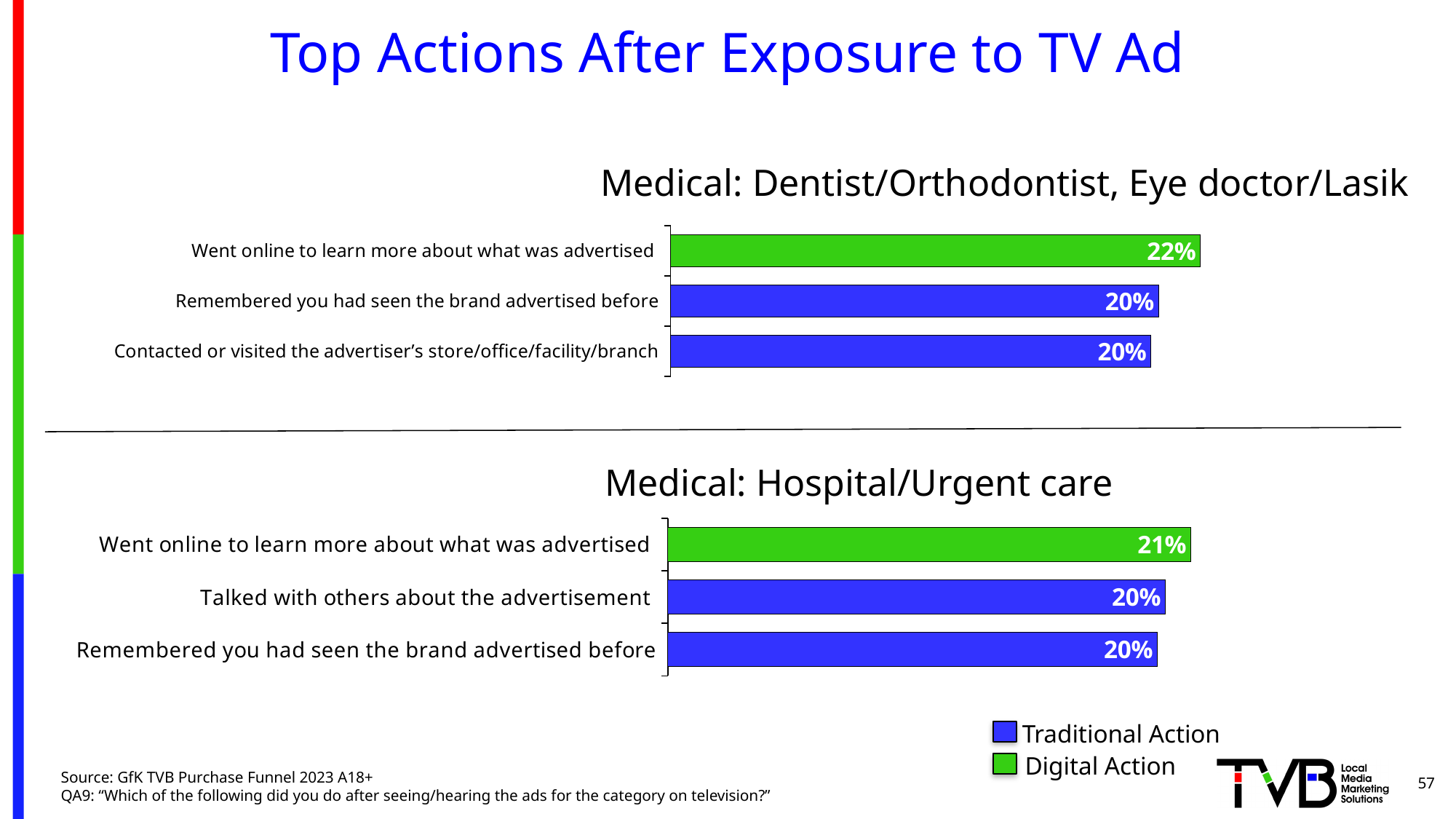
In the 'Medical: Hospital/Urgent care' chart, what is the value for 'Went online to learn more about what was advertised'? 21% How many actions are shown in the 'Medical: Hospital/Urgent care' chart? 3 How many entries does the legend on the slide list? 2 In the 'Medical: Dentist/Orthodontist, Eye doctor/Lasik' chart, which action has the highest value? Went online to learn more about what was advertised In the 'Medical: Hospital/Urgent care' chart, what is the difference between 'Went online to learn more about what was advertised' and 'Remembered you had seen the brand advertised before'? 1% In the 'Medical: Dentist/Orthodontist, Eye doctor/Lasik' chart, what is the value for 'Went online to learn more about what was advertised'? 22% In the 'Medical: Dentist/Orthodontist, Eye doctor/Lasik' chart, what is the value for 'Contacted or visited the advertiser's store/office/facility/branch'? 20% In the 'Medical: Dentist/Orthodontist, Eye doctor/Lasik' chart, what is the difference between 'Went online to learn more about what was advertised' and 'Remembered you had seen the brand advertised before'? 2% In the 'Medical: Hospital/Urgent care' chart, which action has the highest value? Went online to learn more about what was advertised In the 'Medical: Hospital/Urgent care' chart, what is the value for 'Talked with others about the advertisement'? 20% What type of chart is the 'Medical: Dentist/Orthodontist, Eye doctor/Lasik' chart? Bar chart According to the legend, what colour represents 'Digital Action'? Green